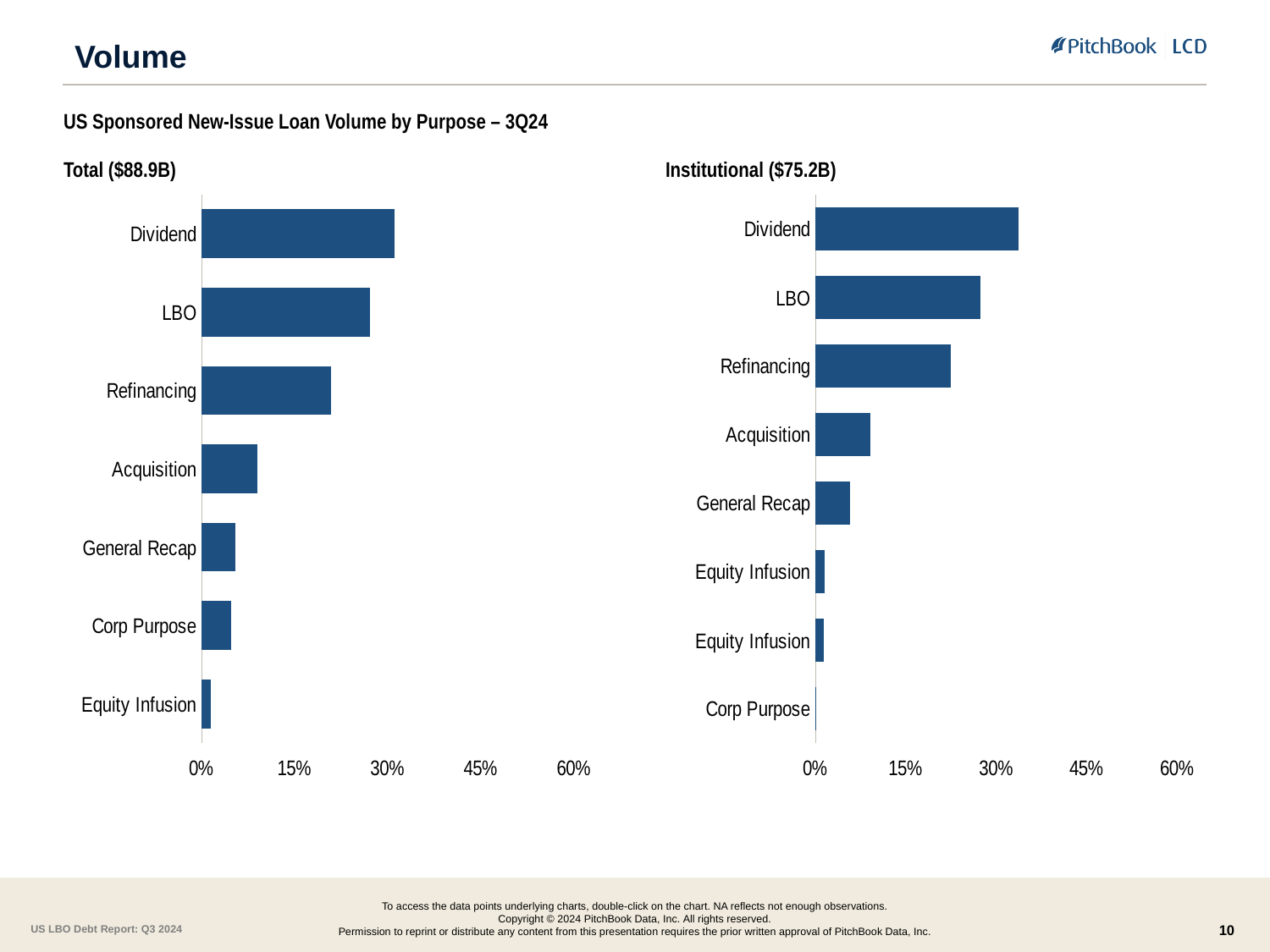
In the Total ($88.9B) chart, which purpose has the lowest share of volume? Equity Infusion In the Total ($88.9B) chart, which is larger, LBO or Refinancing? LBO In the Total ($88.9B) chart, which purpose has the highest share of volume? Dividend In the Institutional ($75.2B) chart, is the value for LBO greater or less than 30%? less In the Institutional ($75.2B) chart, which is larger, Refinancing or Acquisition? Refinancing In the Institutional ($75.2B) chart, which purpose has the highest share of volume? Dividend How many purpose categories are shown in the Total ($88.9B) chart? 7 What is the overall title shown above the two charts? US Sponsored New-Issue Loan Volume by Purpose – 3Q24 What kind of chart is the Total ($88.9B) chart? bar chart In the Total ($88.9B) chart, is the value for Acquisition greater or less than 15%? less In the Total ($88.9B) chart, is the value for Dividend greater or less than 30%? greater In the Institutional ($75.2B) chart, which purpose has the lowest share of volume? Corp Purpose